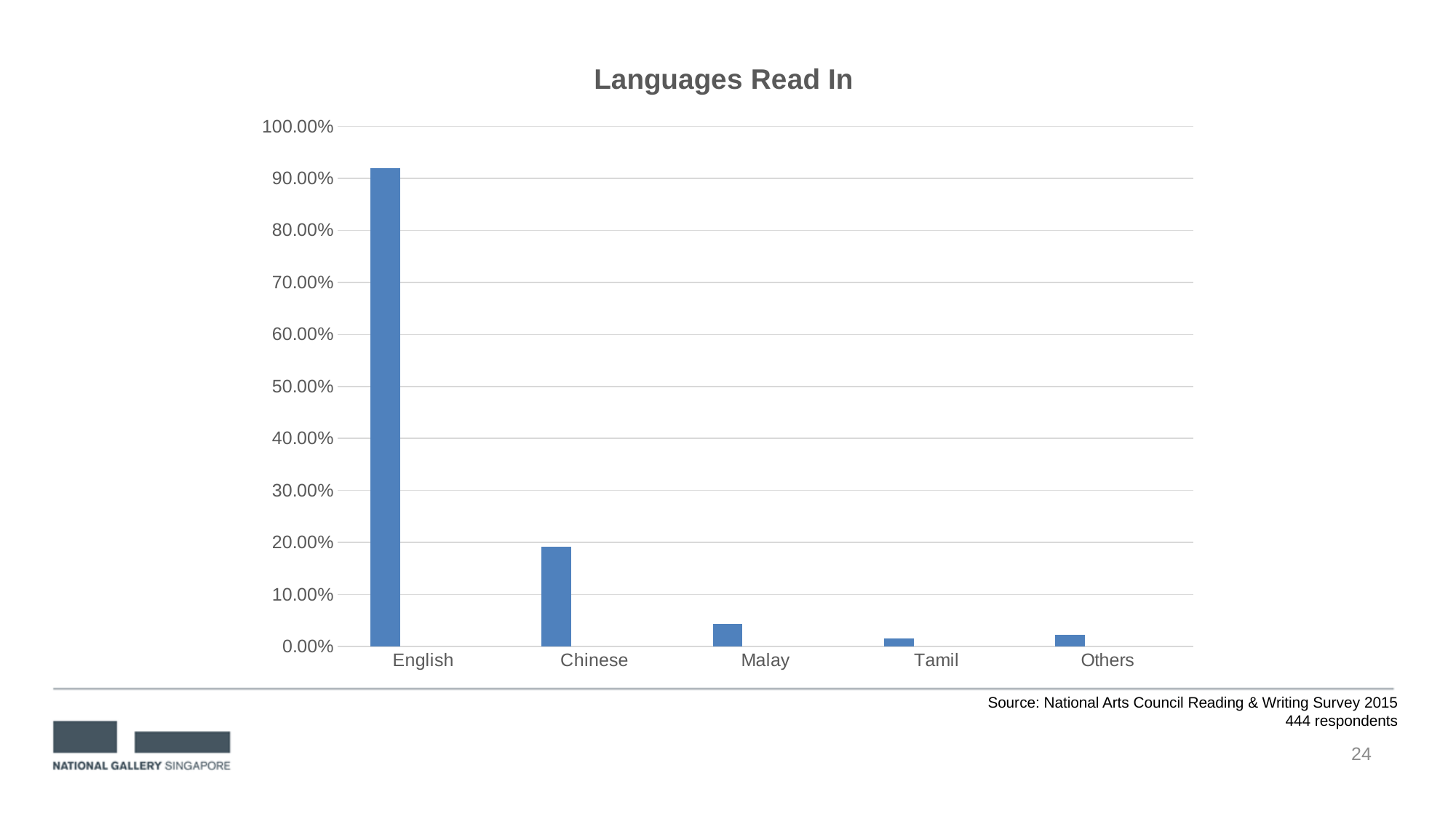
Which language has the highest value? English Is the value for Malay greater or less than 10.00%? less Is the value for Chinese greater or less than 20.00%? less What is the source cited below the chart? National Arts Council Reading & Writing Survey 2015 Which is larger, the value for Others or the value for Tamil? Others What kind of chart is shown on the slide? bar chart What is the title of the chart? Languages Read In Which is larger, the value for Malay or the value for Others? Malay Is the value for English greater or less than 90.00%? greater Which language has the lowest value? Tamil How many language categories are shown on the x axis? 5 Which is larger, the value for Chinese or the value for Malay? Chinese